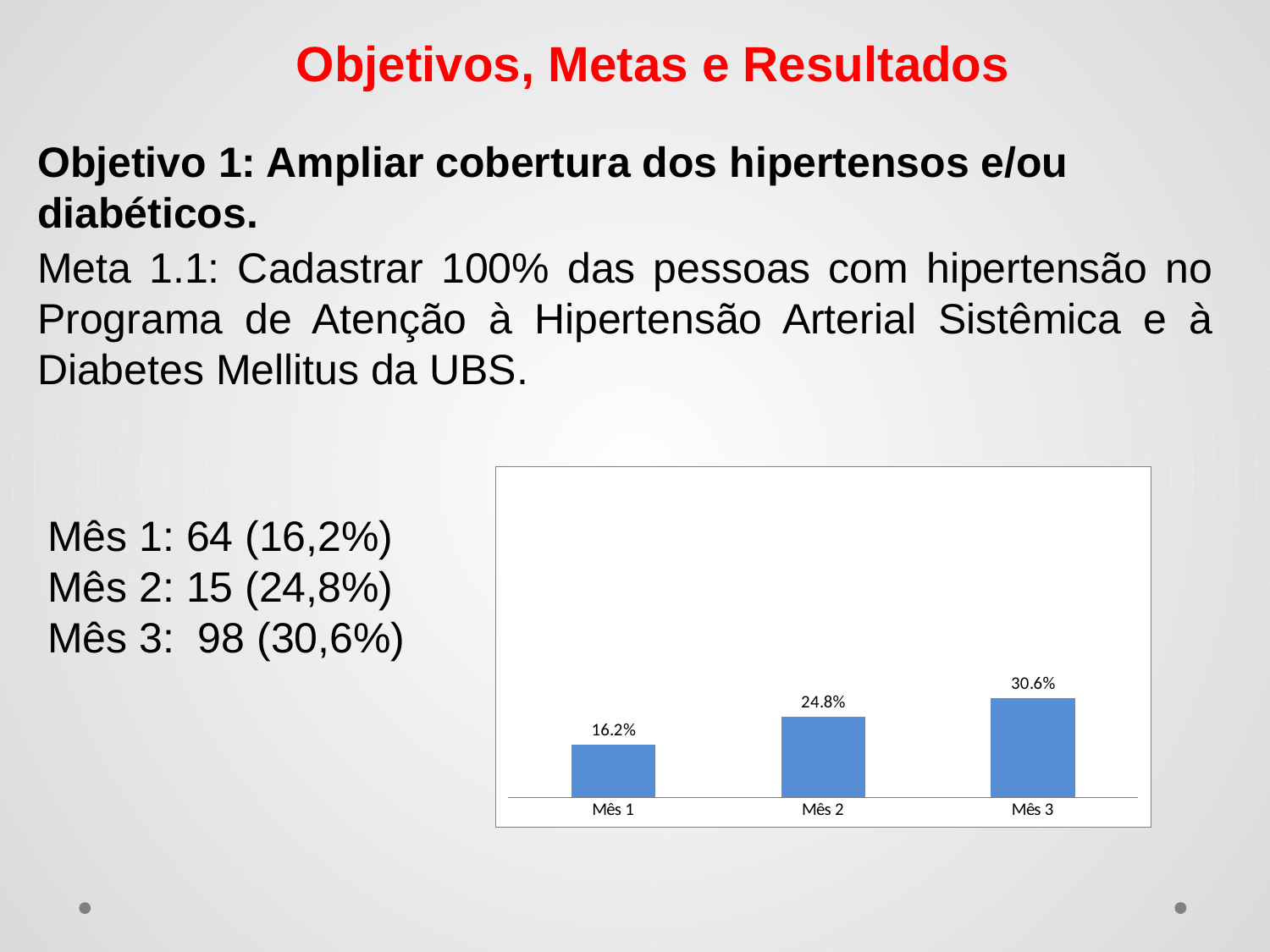
What is the difference between the values for Mês 2 and Mês 1? 8.6% How many categories are shown in the chart? 3 Do the values rise or fall from Mês 1 to Mês 3? Rise What is the difference between the values for Mês 3 and Mês 1? 14.4% Which month has the highest value in the chart? Mês 3 Which is larger, the value for Mês 2 or the value for Mês 3? Mês 3 What is the value for Mês 3 in the chart? 30.6% What colour are the bars in the chart? Blue Which month has the lowest value in the chart? Mês 1 What kind of chart is shown on the slide? Bar chart What is the value for Mês 1 in the chart? 16.2% What is the value for Mês 2 in the chart? 24.8%